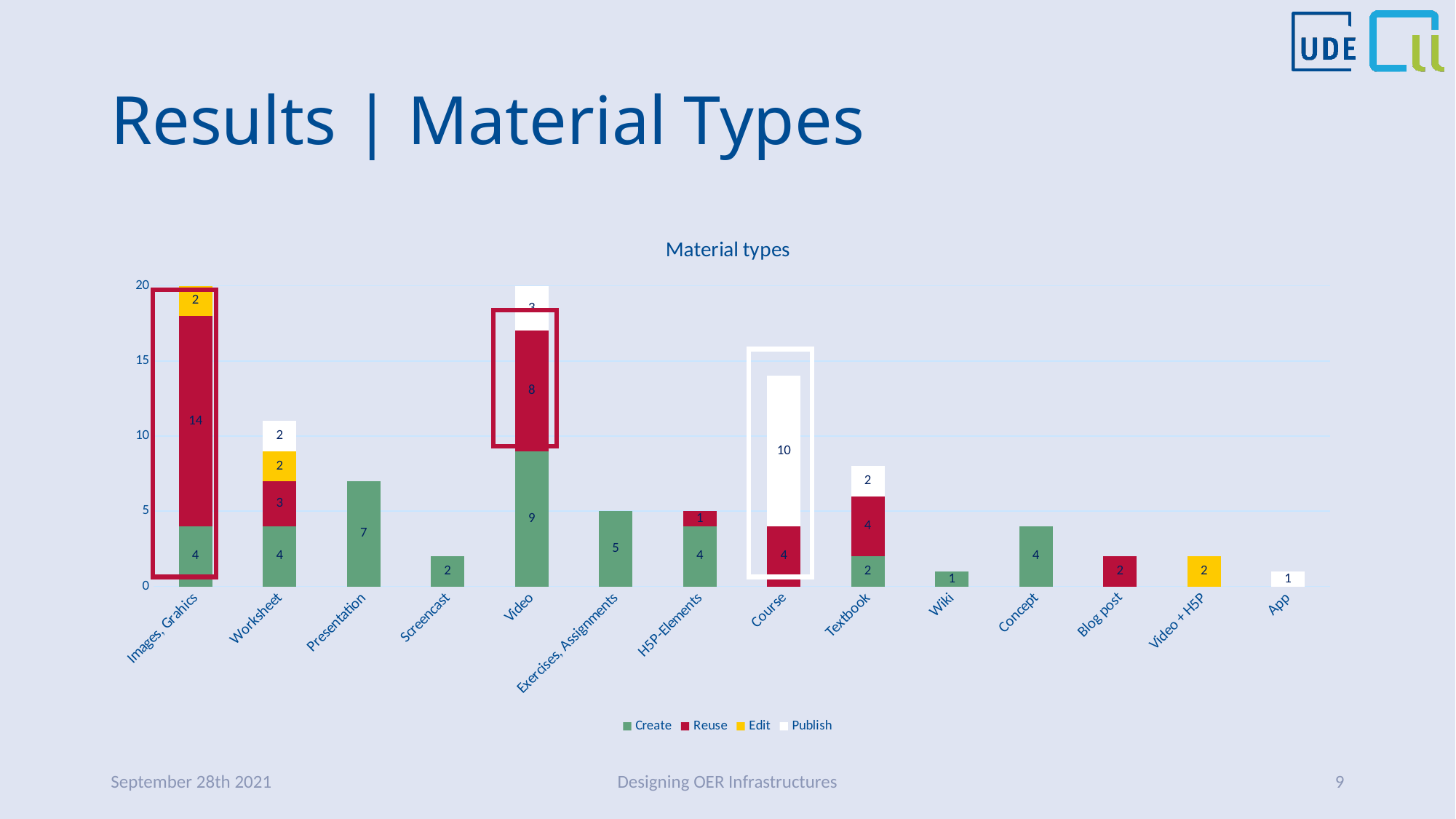
Which category has the highest Reuse value? Images, Grahics Which is larger, the Create value for Exercises, Assignments or the Create value for Concept? Exercises, Assignments What type of chart is shown on the slide? Stacked bar chart What is the total of the stacked bar for Textbook? 8 What is the total of the stacked bar for Worksheet? 11 What is the Reuse value for Images, Grahics? 14 What is the difference between the Create value for Presentation and the Create value for Screencast? 5 Which series is shown in yellow in the legend? Edit What is the Publish value for Course? 10 How many material type categories are shown on the x axis of the chart? 14 How many series does the legend of the 'Material types' chart list? 4 What is the Create value for Video? 9